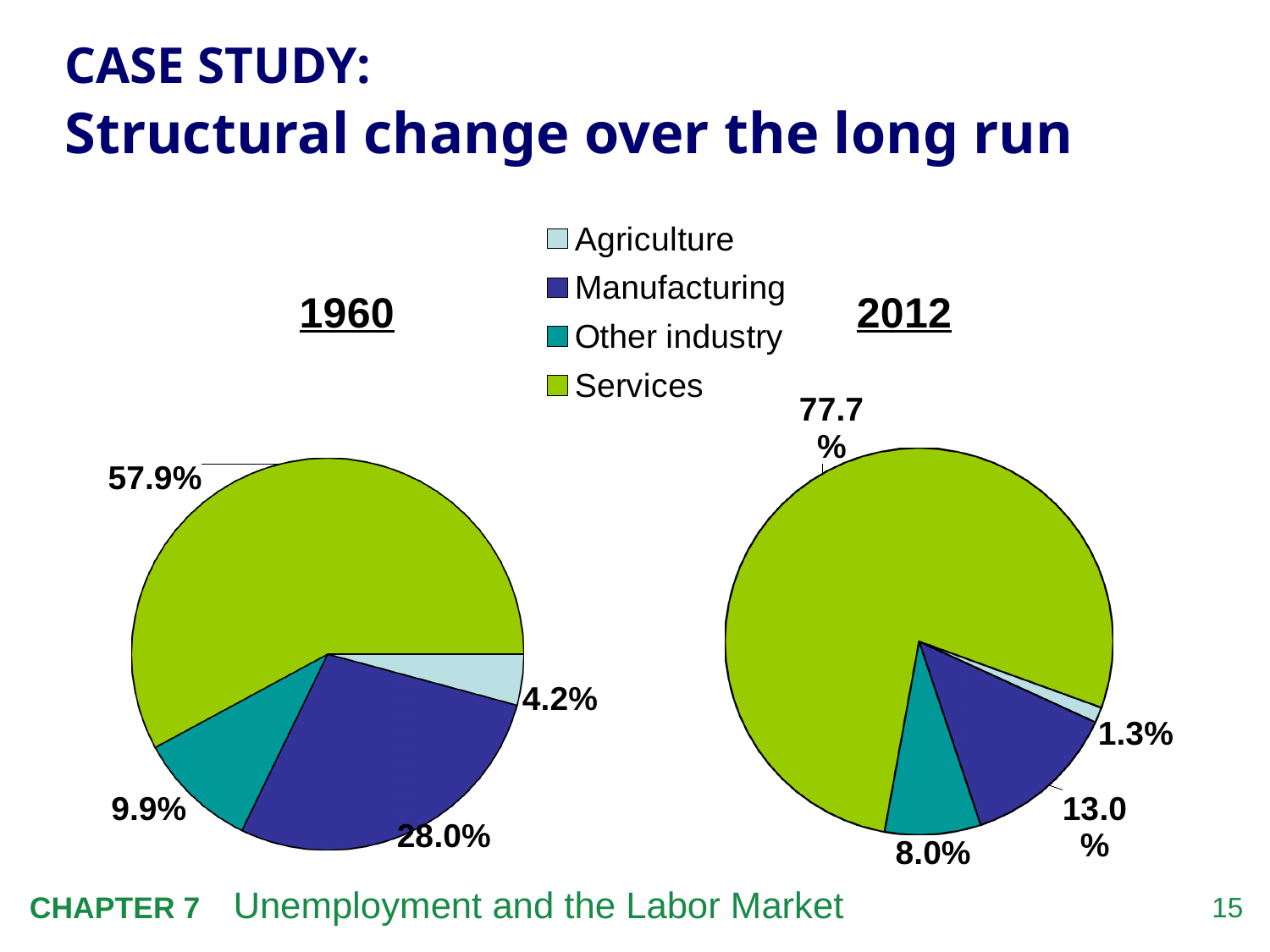
What type of chart is used to show the 1960 and 2012 data? Pie chart In the 2012 pie chart, what share does Manufacturing have? 13.0% In the 1960 pie chart, what share does Agriculture have? 4.2% In the 1960 pie chart, what is the difference between the Manufacturing share and the Other industry share? 18.1 percentage points In the 1960 pie chart, what share does Services have? 57.9% How many sectors does each pie chart show? 4 In the 1960 pie chart, which sector has the smallest share? Agriculture In the 2012 pie chart, what share does Other industry have? 8.0% What is the difference between the Services share in 2012 and the Services share in 1960? 19.8 percentage points Which is larger: the Manufacturing share in 1960 or the Manufacturing share in 2012? 1960 Which colour represents Services in the legend? Green In the 2012 pie chart, which sector has the largest share? Services